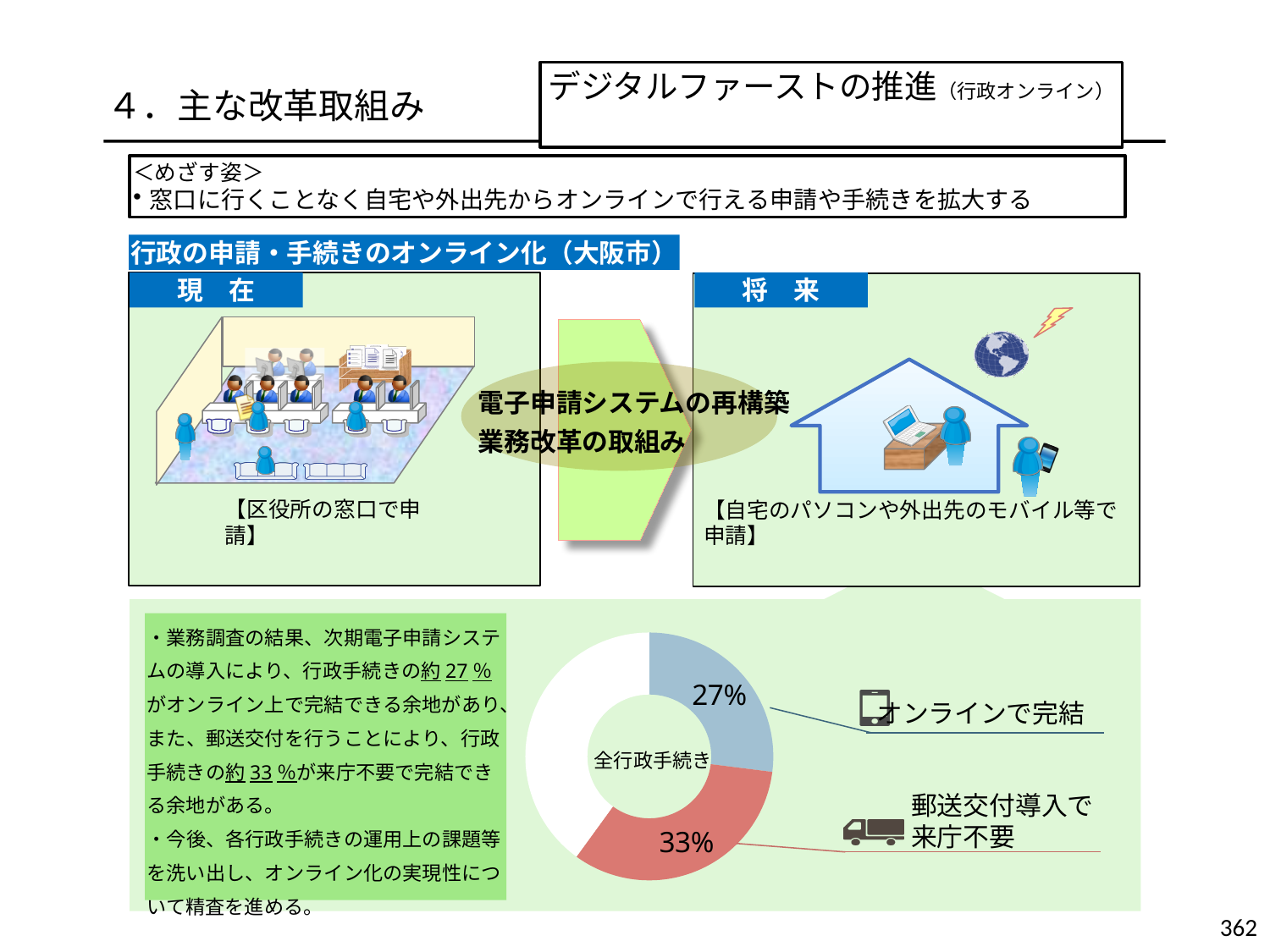
What is the difference in percentage points between the 33% slice and the 27% slice? 6 percentage points Is the value for the オンラインで完結 slice greater or less than 30%? less What is the combined percentage of the two labelled slices (27% and 33%)? 60% What text is written in the centre of the doughnut chart? 全行政手続き What colour is the slice labelled 33%? Red Which labelled slice of the doughnut chart has the smallest value? オンラインで完結 (27%) What percentage is shown for the slice labelled オンラインで完結? 27% Which labelled slice is larger, オンラインで完結 or 郵送交付導入で来庁不要? 郵送交付導入で来庁不要 How many slices in the doughnut chart have a percentage label printed on them? 2 Is the value for the 郵送交付導入で来庁不要 slice greater or less than 30%? greater What kind of chart is shown at the bottom of the slide? Doughnut (pie) chart What percentage is shown for the slice labelled 郵送交付導入で来庁不要? 33%